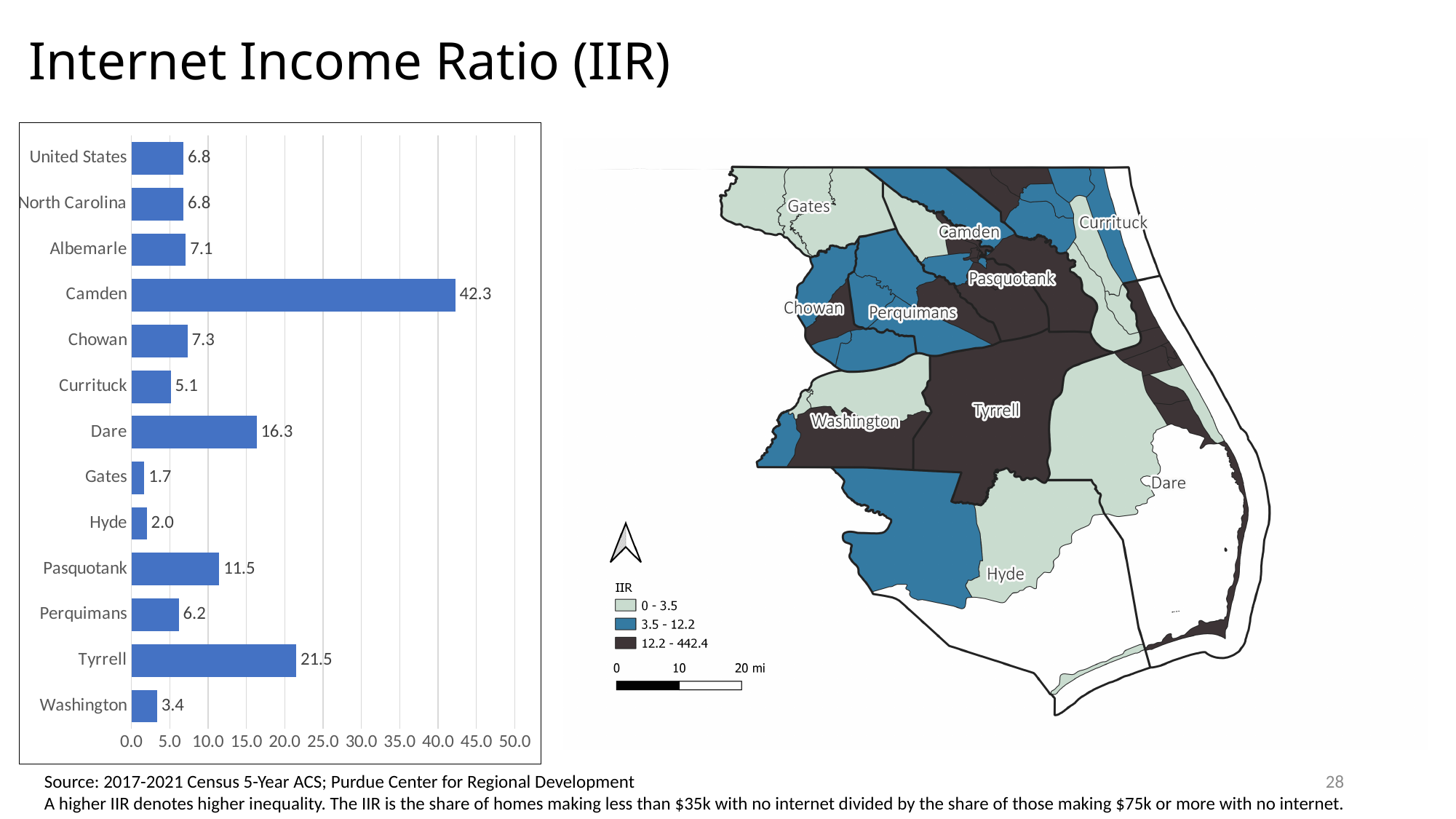
What is the value for Washington in the bar chart? 3.4 Is the value for Dare in the bar chart greater or less than 15.0? greater What is the Internet Income Ratio value for Camden in the bar chart? 42.3 How many categories are shown in the bar chart? 13 Which category has the lowest value in the bar chart? Gates Which category has the highest value in the bar chart? Camden What is the value for Tyrrell in the bar chart? 21.5 Which has a larger value in the bar chart, Dare or Pasquotank? Dare What is the difference between the values for Camden and Tyrrell in the bar chart? 20.8 What is the value for Gates in the bar chart? 1.7 What kind of chart is on the left side of the slide? bar chart What is the difference between the values for Chowan and Currituck in the bar chart? 2.2